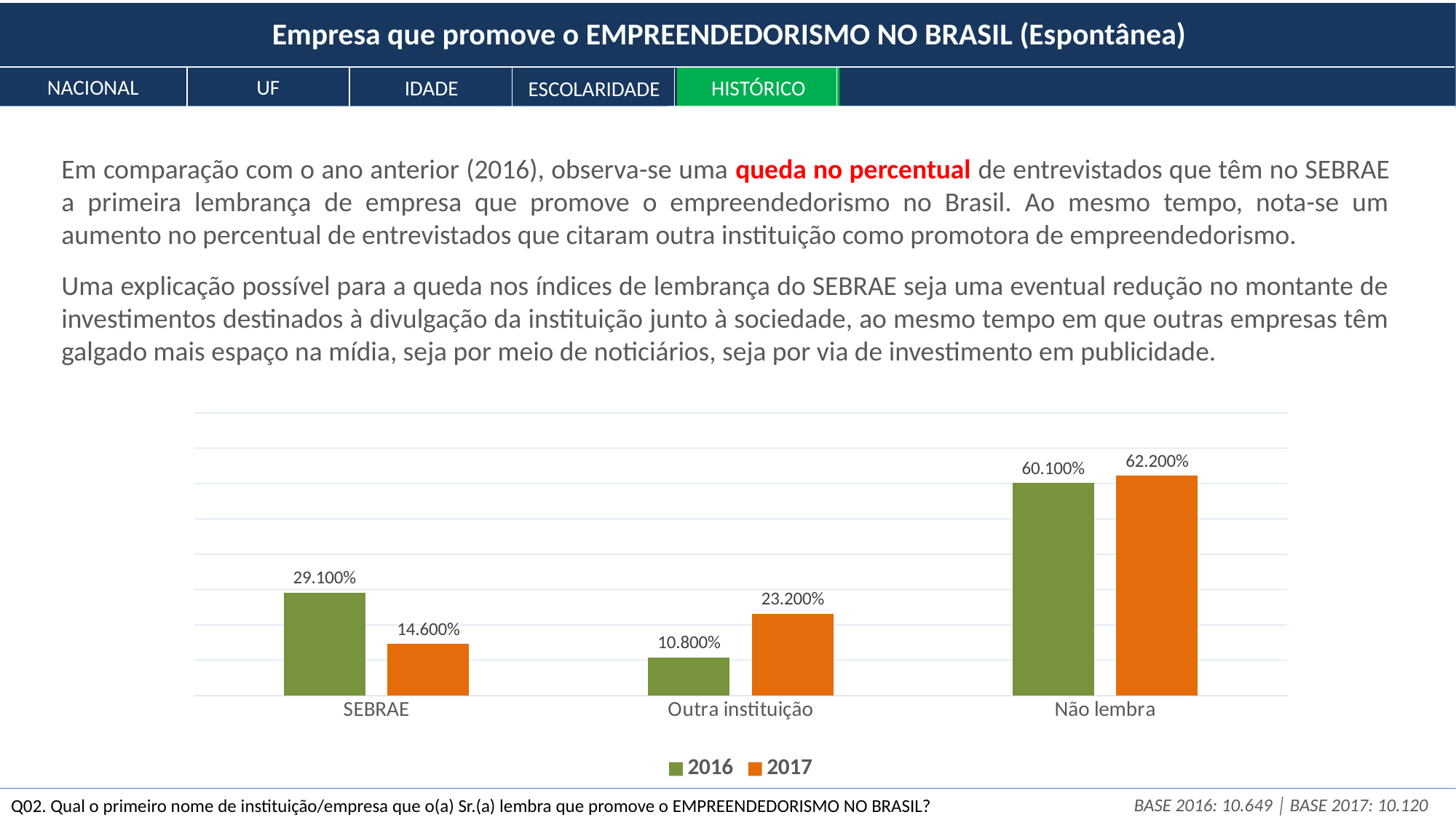
Which category has the lowest value in 2016? Outra instituição Which category has the highest value in 2017? Não lembra How many categories are shown on the x axis? 3 What is the difference between the 2016 and 2017 values for SEBRAE? 14.500% Which is larger for Outra instituição: the 2016 value or the 2017 value? 2017 What is the value for Outra instituição in 2017? 23.200% What is the value for SEBRAE in 2017? 14.600% What is the value for SEBRAE in 2016? 29.100% What kind of chart is shown on the slide? Bar chart Which colour represents the 2017 series in the chart? Orange How many series does the legend list? 2 What is the value for Não lembra in 2016? 60.100%